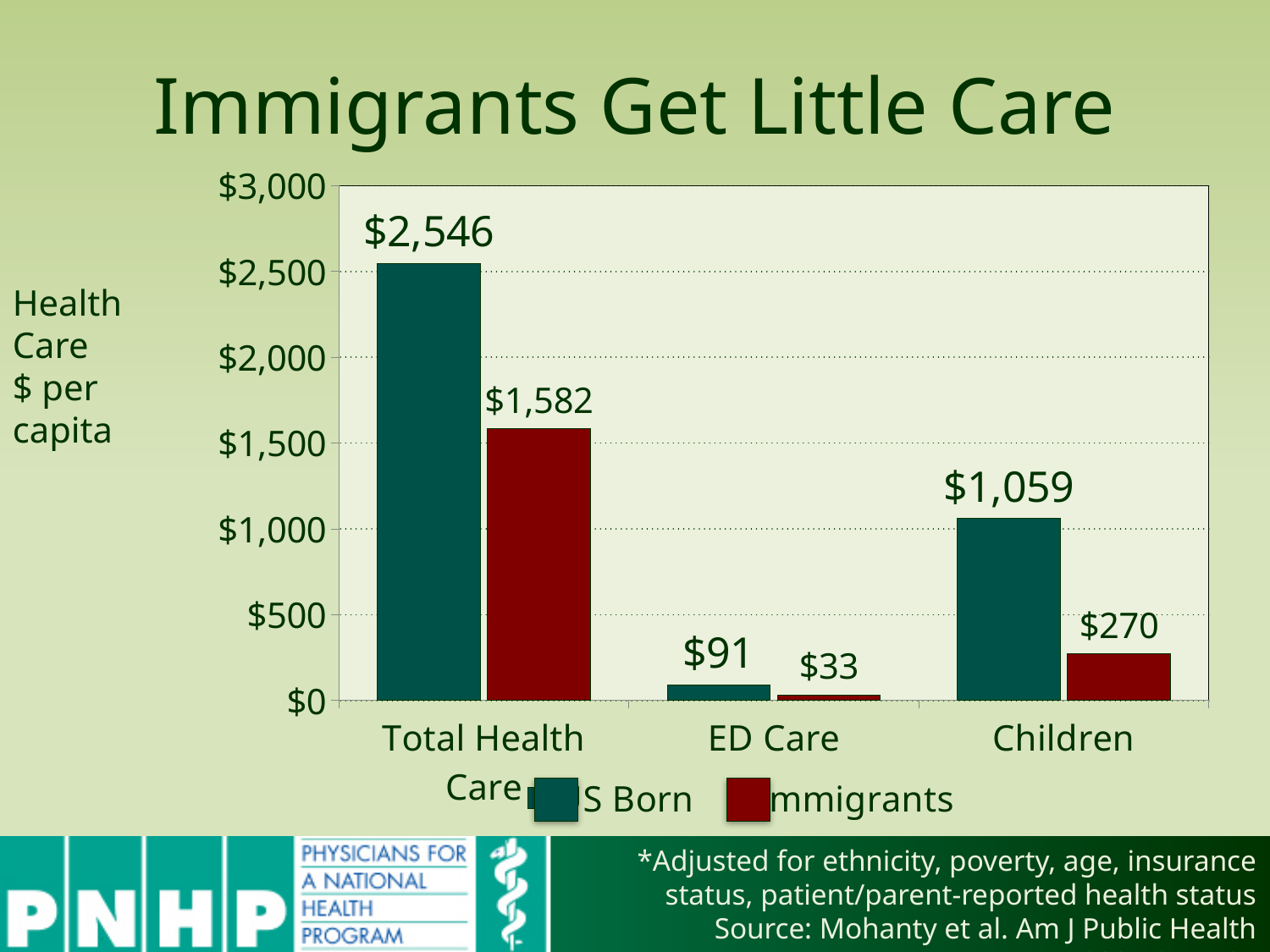
What is the value for US Born in the Children category? $1,059 Which category has the lowest value for Immigrants? ED Care What is the difference between the US Born and Immigrants values in the Children category? $789 How many series does the legend list? 2 In the ED Care category, which is larger: the US Born value or the Immigrants value? US Born What kind of chart is shown on the slide? Bar chart What is the health care spending per capita for Immigrants in the Total Health Care category? $1,582 What is the health care spending per capita for US Born in the Total Health Care category? $2,546 How many categories are shown on the x axis? 3 Which category has the highest value for US Born? Total Health Care What is the difference between the US Born and Immigrants values in the Total Health Care category? $964 What is the value for Immigrants in the ED Care category? $33